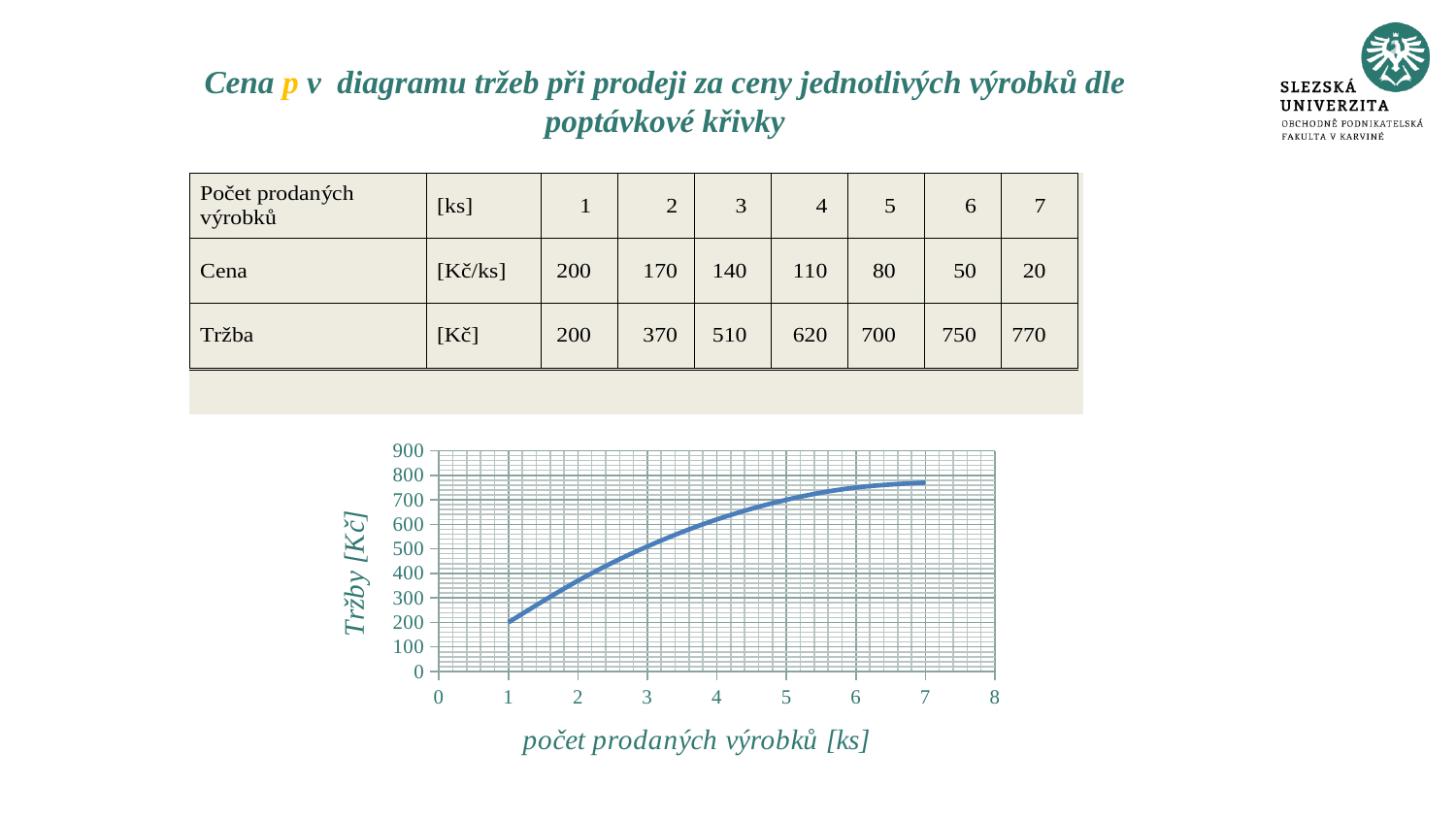
At which number of products sold is the revenue lowest? 1 What is the revenue (Tržba) when 4 products are sold? 620 How many data points does the line in the chart have? 7 What is the label of the horizontal axis of the chart? počet prodaných výrobků [ks] What is the revenue (Tržba) when 1 product is sold? 200 What kind of chart is shown on the slide? line chart What is the label of the vertical axis of the chart? Tržby [Kč] What is the revenue (Tržba) when 7 products are sold? 770 Is the revenue at 2 products sold greater or less than 300? greater Do the revenue (Tržby) values rise or fall as the number of products sold increases along the x axis? rise At which number of products sold is the revenue highest? 7 What is the difference between the revenue at 7 products sold and at 1 product sold? 570